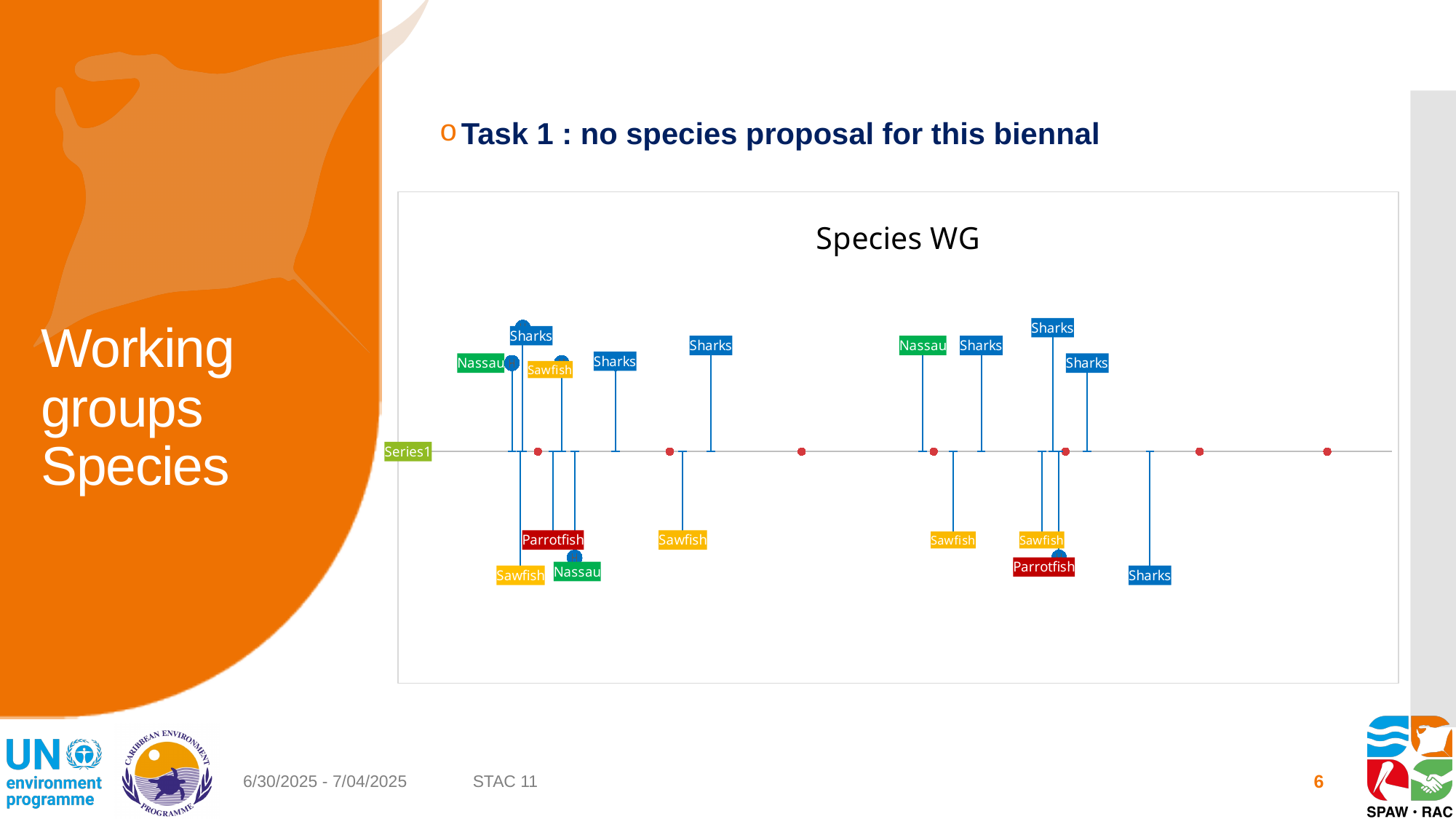
How many different species names appear as labels on the chart? 4 Which species label appears least often on the chart? Parrotfish What is the title of the chart? Species WG Which species label appears most often on the chart? Sharks How many 'Parrotfish' labels are on the chart? 2 What colour are the 'Sawfish' labels on the chart? Yellow What kind of chart is shown on the slide? Timeline chart How many 'Nassau' labels are on the chart? 3 What series name is shown at the left end of the horizontal axis line? Series1